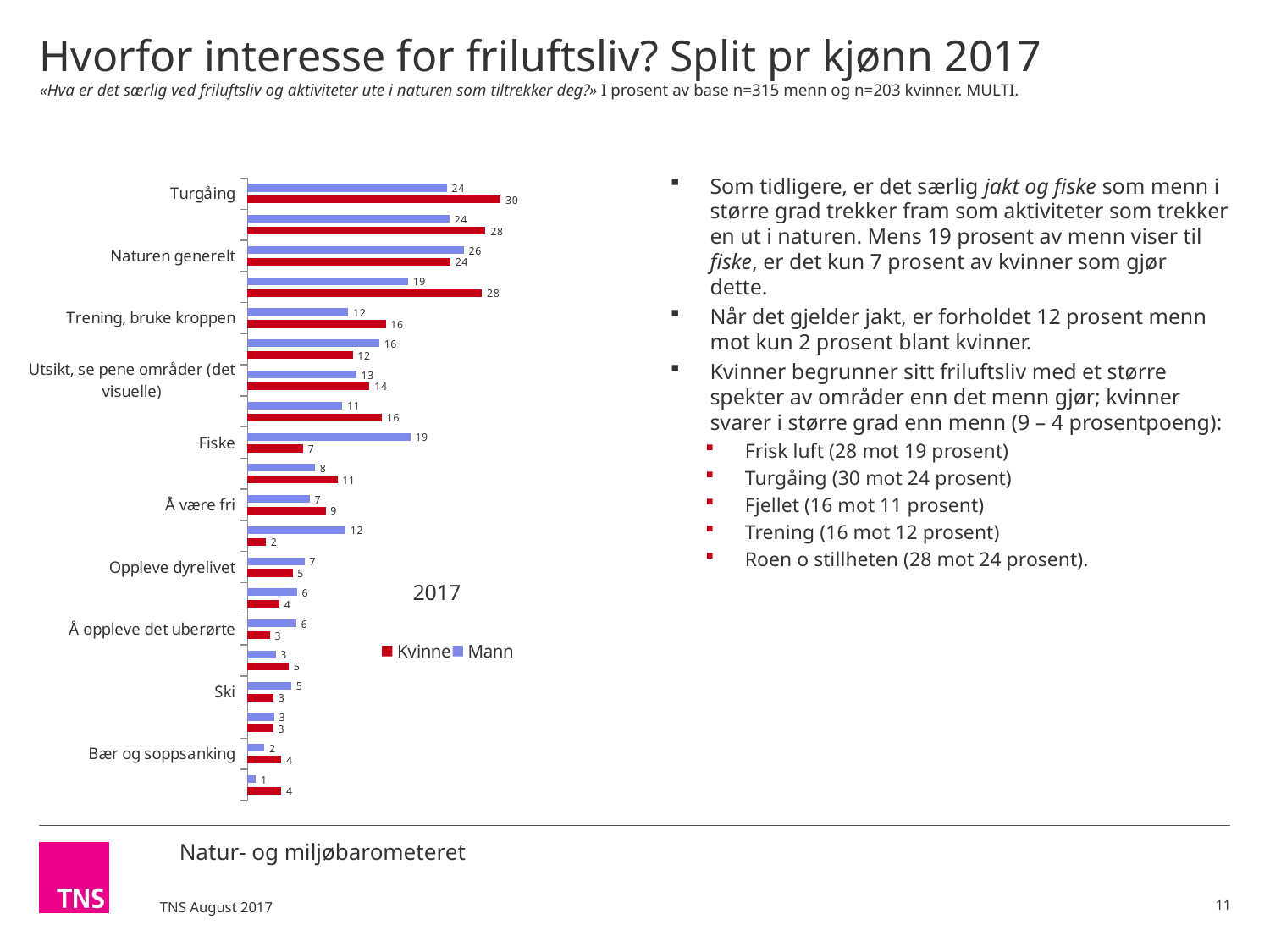
Which category has the highest Kvinne value? Turgåing What is the Mann value for Naturen generelt? 26 What type of chart is shown on the slide? Bar chart For Ski, which series has the larger value, Kvinne or Mann? Mann What is the Mann value for Fiske? 19 What is the Kvinne value for Turgåing? 30 For Å være fri, which series has the larger value, Kvinne or Mann? Kvinne What is the Kvinne value for Trening, bruke kroppen? 16 What is the Mann value for Bær og soppsanking? 2 How many series does the legend list? 2 What is the difference between the Kvinne and Mann values for Turgåing? 6 What is the difference between the Mann and Kvinne values for Fiske? 12